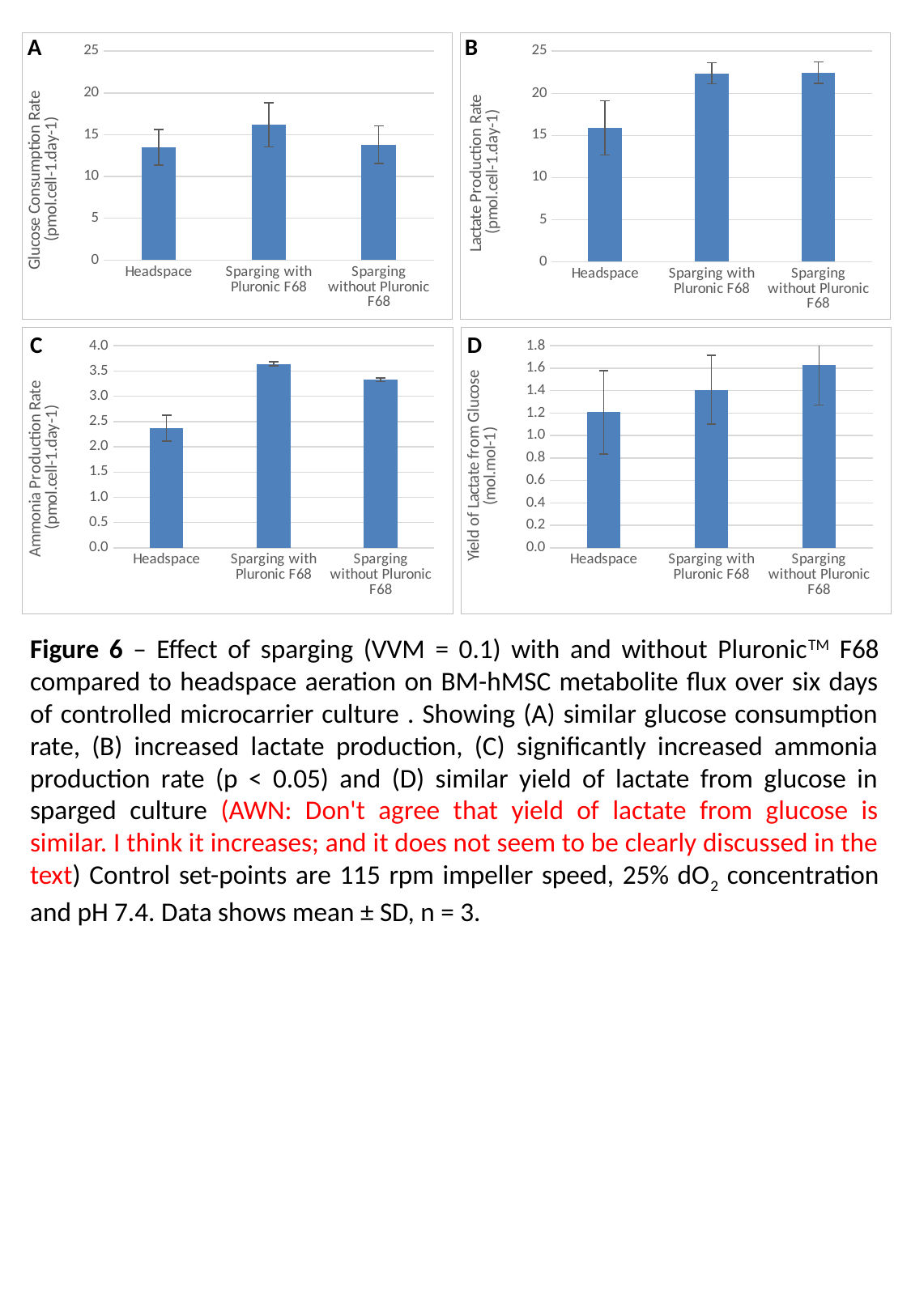
In chart B (Lactate Production Rate), which condition has the lowest value? Headspace What type of chart is chart B (Lactate Production Rate)? Bar chart In chart A (Glucose Consumption Rate), which condition has the highest value? Sparging with Pluronic F68 In chart C (Ammonia Production Rate), is the value for Sparging without Pluronic F68 greater or less than 3.5? less In chart D (Yield of Lactate from Glucose), which condition has the highest value? Sparging without Pluronic F68 What is the y-axis label of chart C? Ammonia Production Rate (pmol.cell-1.day-1) In chart D (Yield of Lactate from Glucose), is the value for Headspace greater or less than 1.0? greater In chart C (Ammonia Production Rate), which is larger, Headspace or Sparging without Pluronic F68? Sparging without Pluronic F68 How many conditions are plotted in chart D (Yield of Lactate from Glucose)? 3 In chart B (Lactate Production Rate), is the value for Sparging with Pluronic F68 greater or less than 20? greater In chart C (Ammonia Production Rate), which condition has the highest value? Sparging with Pluronic F68